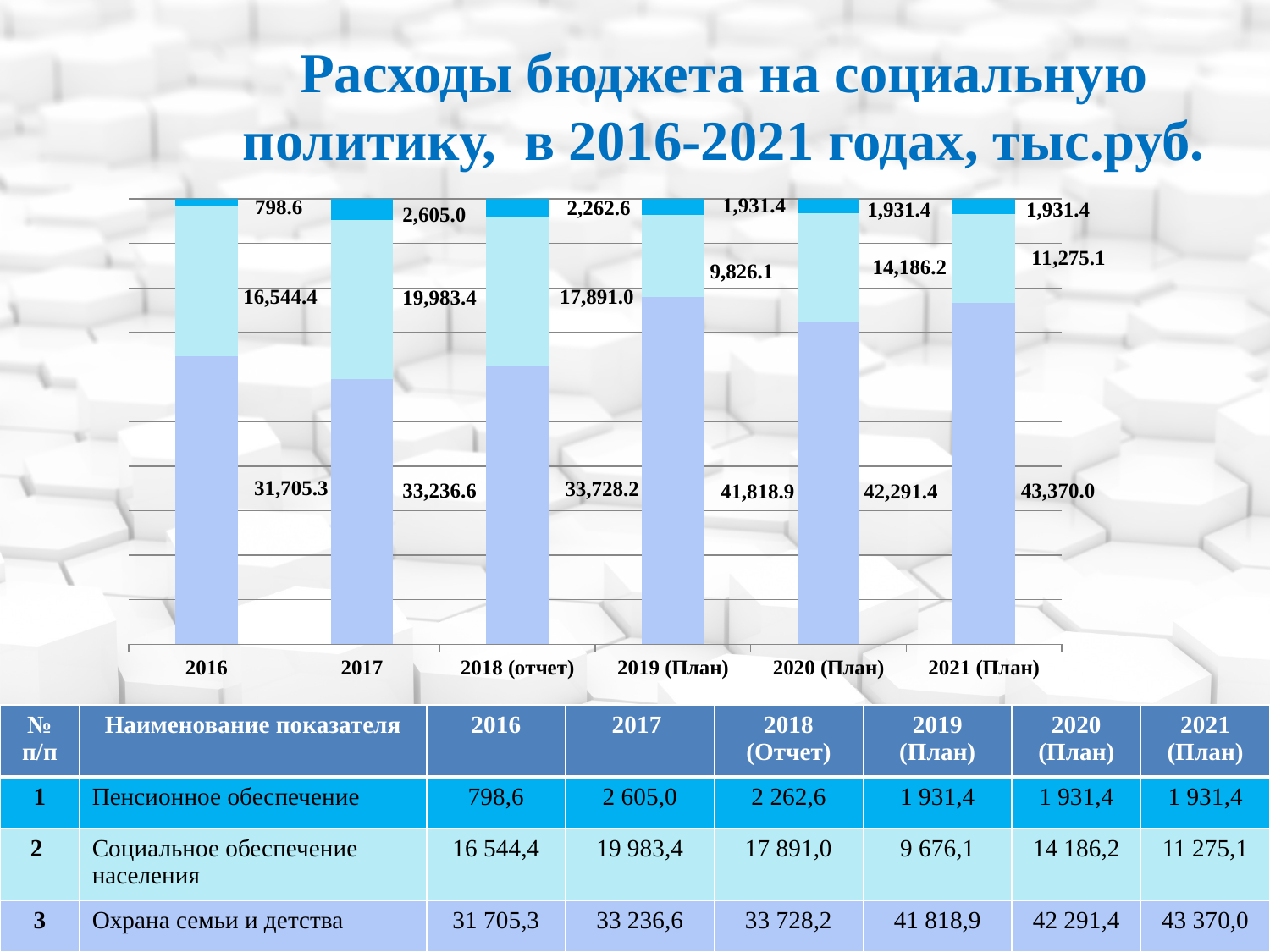
What is the value of the top segment (Пенсионное обеспечение) of the bar for 2017? 2,605.0 What is the difference between the bottom segment values for 2021 (План) and 2016? 11,664.7 In which year is the bottom segment (Охрана семьи и детства) the highest? 2021 (План) How many year categories are shown along the x axis of the chart? 6 Which year has the larger middle segment (Социальное обеспечение населения): 2017 or 2018 (отчет)? 2017 In which year is the top segment (Пенсионное обеспечение) the lowest? 2016 What is the title of the chart on the slide? Расходы бюджета на социальную политику, в 2016-2021 годах, тыс.руб. What is the value of the middle segment (Социальное обеспечение населения) of the bar for 2020 (План)? 14,186.2 Do the values of the bottom segment (Охрана семьи и детства) rise or fall from 2016 to 2021 (План)? Rise What kind of chart is shown on the slide? Stacked bar chart What is the value of the bottom segment (Охрана семьи и детства) of the bar for 2016? 31,705.3 What is the total of the stacked bar for 2016? 49,048.3